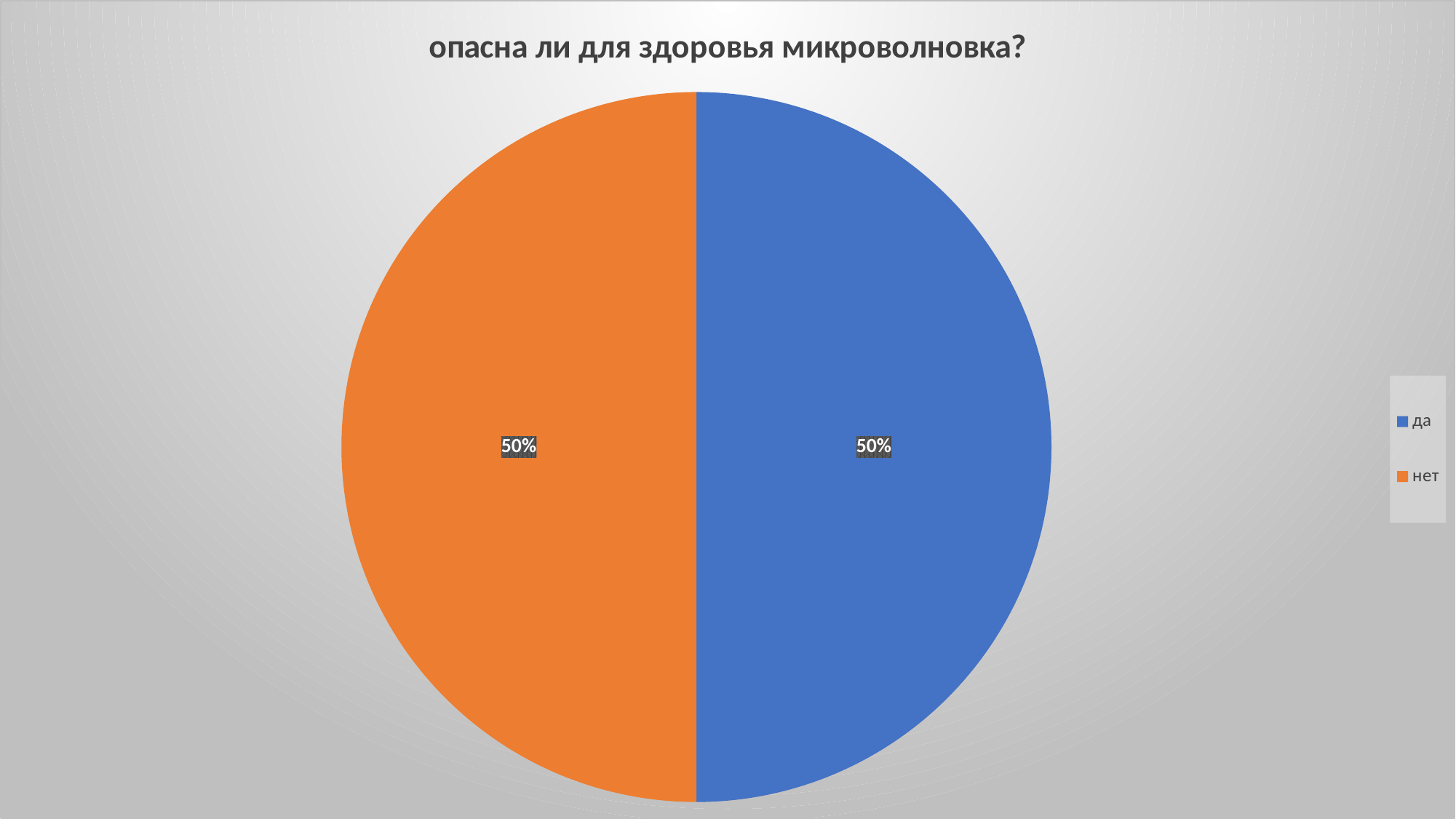
What share of the pie does the "да" slice take? 50% Which colour represents "нет" in the chart? orange What kind of chart is shown on the slide? pie chart How many slices does the pie chart have? 2 What is the total of the "да" and "нет" shares? 100% How many entries does the legend list? 2 What is the difference between the "да" and "нет" shares? 0% What share of the pie does the "нет" slice take? 50% What is the title of the chart? опасна ли для здоровья микроволновка?